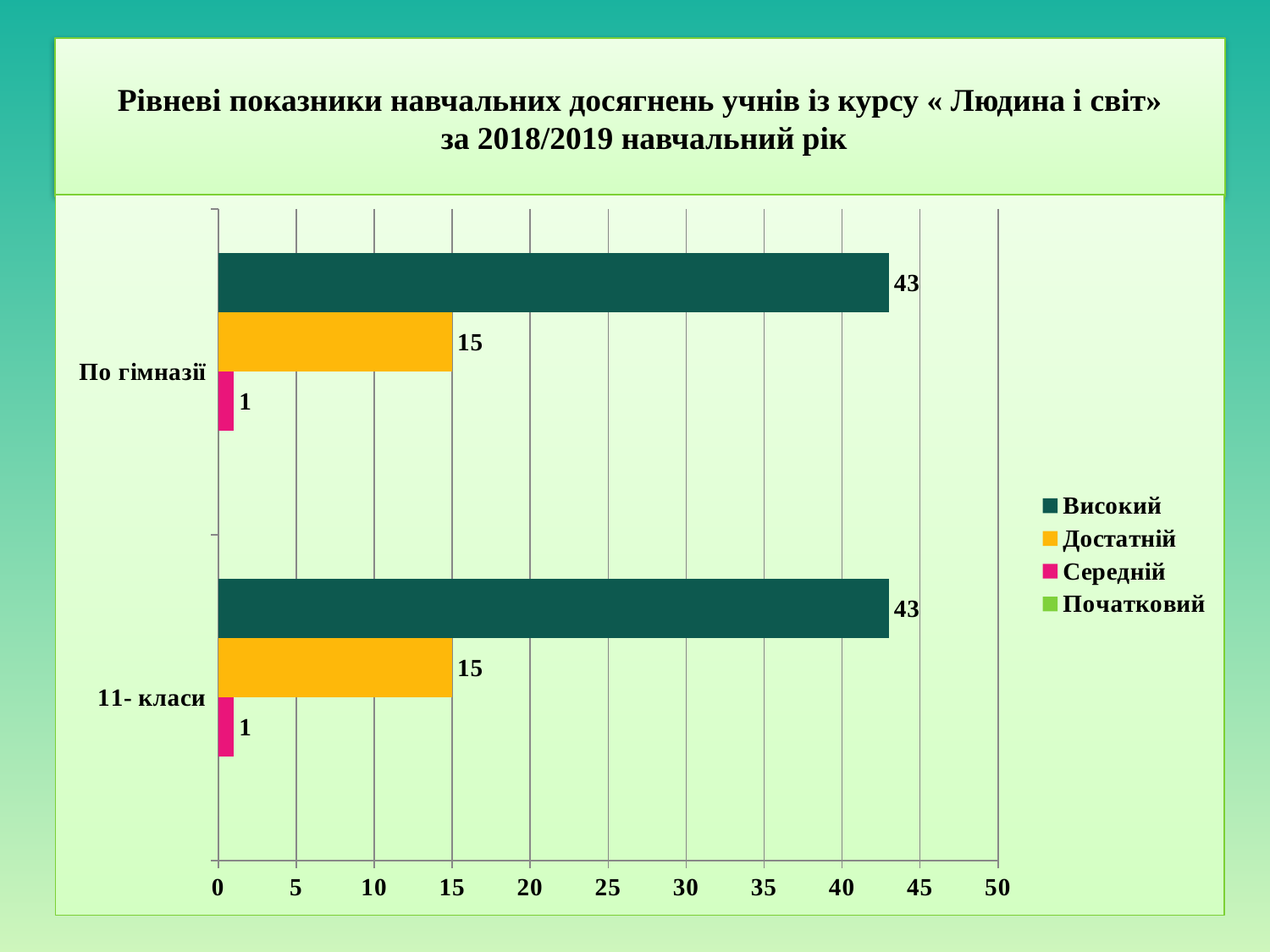
What is the difference between the Високий and Достатній values for 11- класи? 28 What is the value for Середній in the По гімназії category? 1 What kind of chart is shown on the slide? bar chart Which series has the highest value in the 11- класи category? Високий What is the value for Високий in the По гімназії category? 43 How many categories are shown on the vertical axis? 2 How many series does the legend list? 4 What colour represents the Достатній series? yellow Which is larger for По гімназії: the Достатній value or the Середній value? Достатній Which series has the lowest labelled value in the По гімназії category? Середній Is the value for Високий in 11- класи greater or less than 40? greater What is the value for Достатній in the 11- класи category? 15